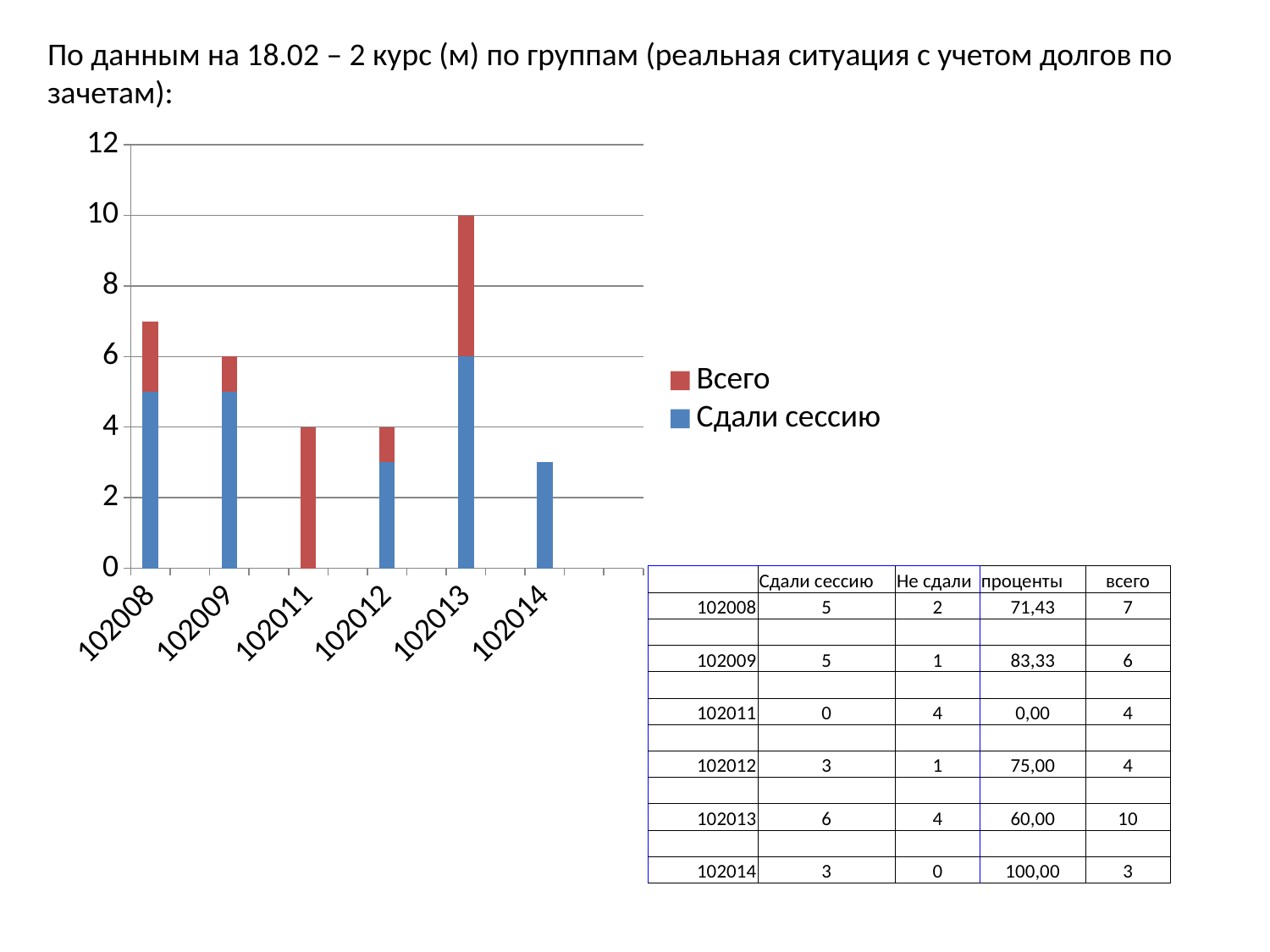
How many series does the chart legend list? 2 Which group has the shortest bar in the chart? 102014 What is the difference between the total bar heights of groups 102013 and 102014? 7 What are the two entries listed in the chart legend? Всего, Сдали сессию What is the value of 'Сдали сессию' for group 102011? 0 Which group has the tallest bar in the chart? 102013 What is the total height of the stacked bar for group 102013? 10 Which group has a taller bar, 102008 or 102009? 102008 What kind of chart is shown on the slide? bar chart What is the value of 'Сдали сессию' for group 102013? 6 How many groups (categories) are shown on the x axis of the chart? 6 Is the total bar height for group 102008 greater or less than 6? greater